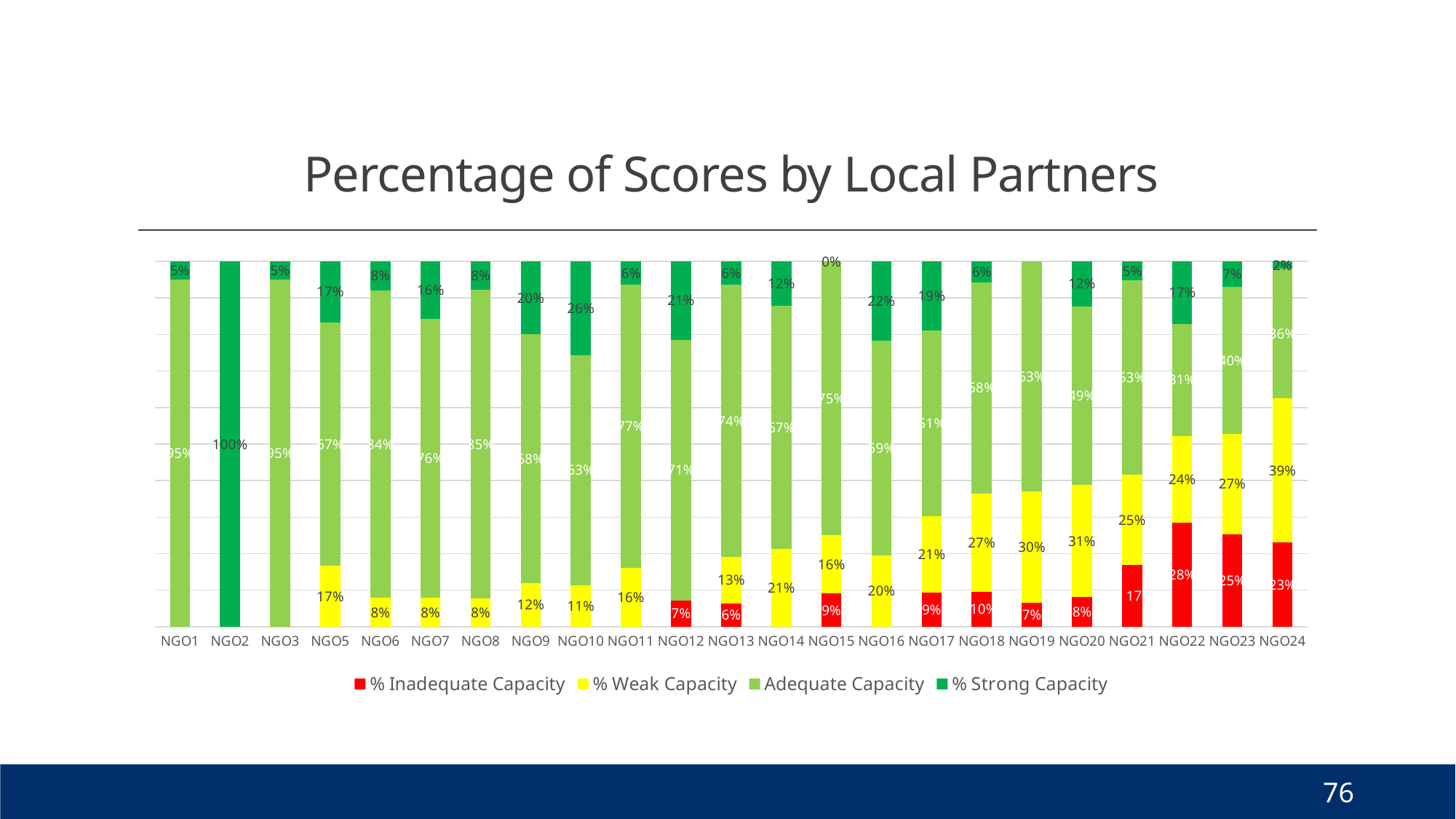
What kind of chart is shown on the slide? Stacked bar chart Which is larger, the % Strong Capacity value for NGO10 or for NGO16? NGO10 What is the % Weak Capacity value for NGO24? 39% What is the % Inadequate Capacity value for NGO22? 28% Which NGO has the highest % Weak Capacity value? NGO24 How many series does the legend list? 4 What is the title of the chart? Percentage of Scores by Local Partners How many NGO categories are shown on the x axis? 23 Which NGO has the highest % Strong Capacity value? NGO2 What is the Adequate Capacity value for NGO10? 63% What is the difference between the Adequate Capacity values for NGO1 and NGO22? 64% Which NGO has the highest % Inadequate Capacity value? NGO22